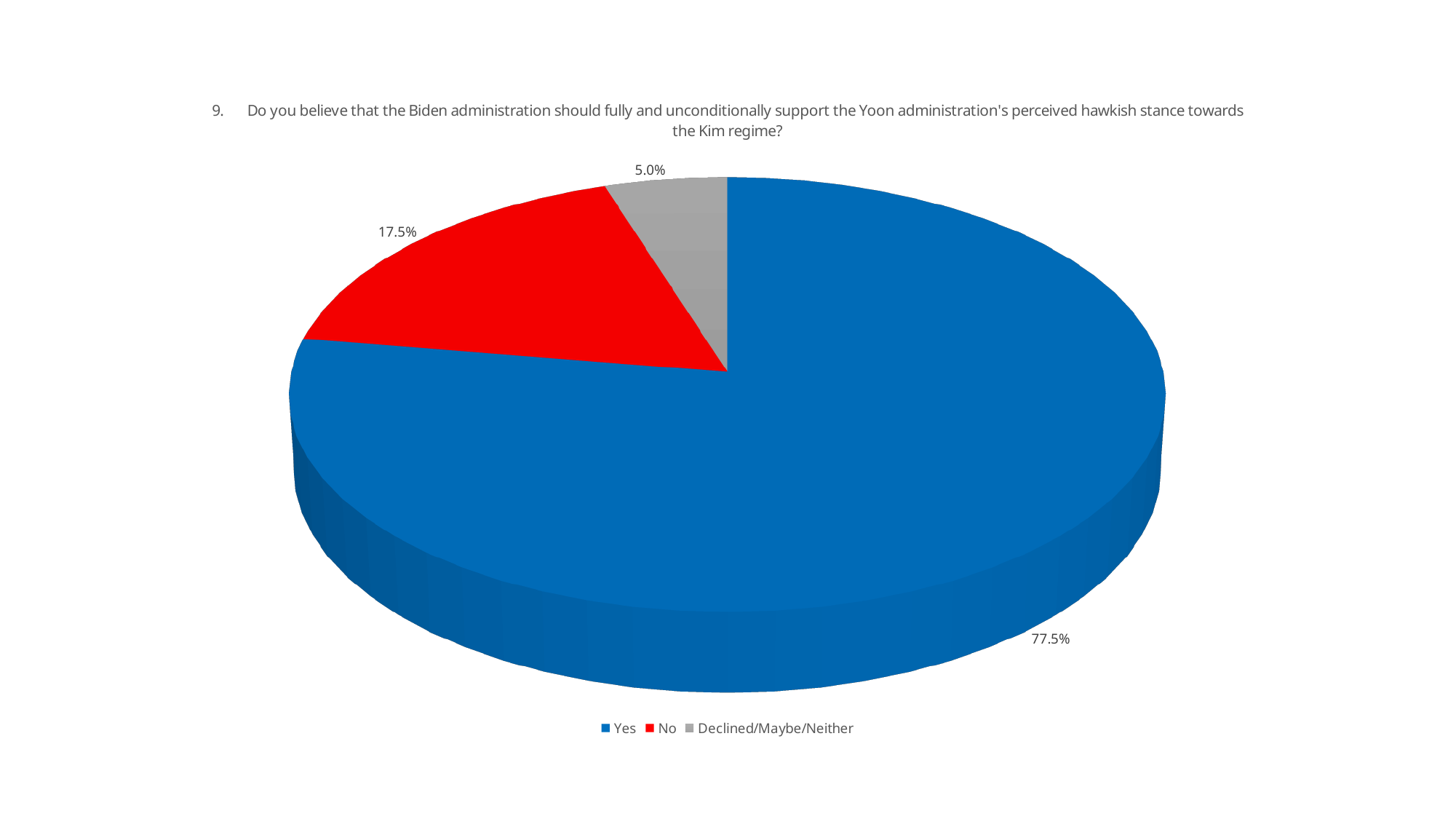
What is the difference in percentage points between the Yes and No shares? 60.0 How many entries does the legend list? 3 What percentage of respondents answered No? 17.5% What percentage of respondents answered Declined/Maybe/Neither? 5.0% Which is larger, the share for No or the share for Declined/Maybe/Neither? No What percentage of respondents answered Yes? 77.5% What kind of chart is shown on the slide? pie chart Which response has the smallest share of the pie? Declined/Maybe/Neither What colour is the slice representing No? red Which response has the largest share of the pie? Yes How many slices does the pie chart have? 3 What is the difference in percentage points between the No and Declined/Maybe/Neither shares? 12.5